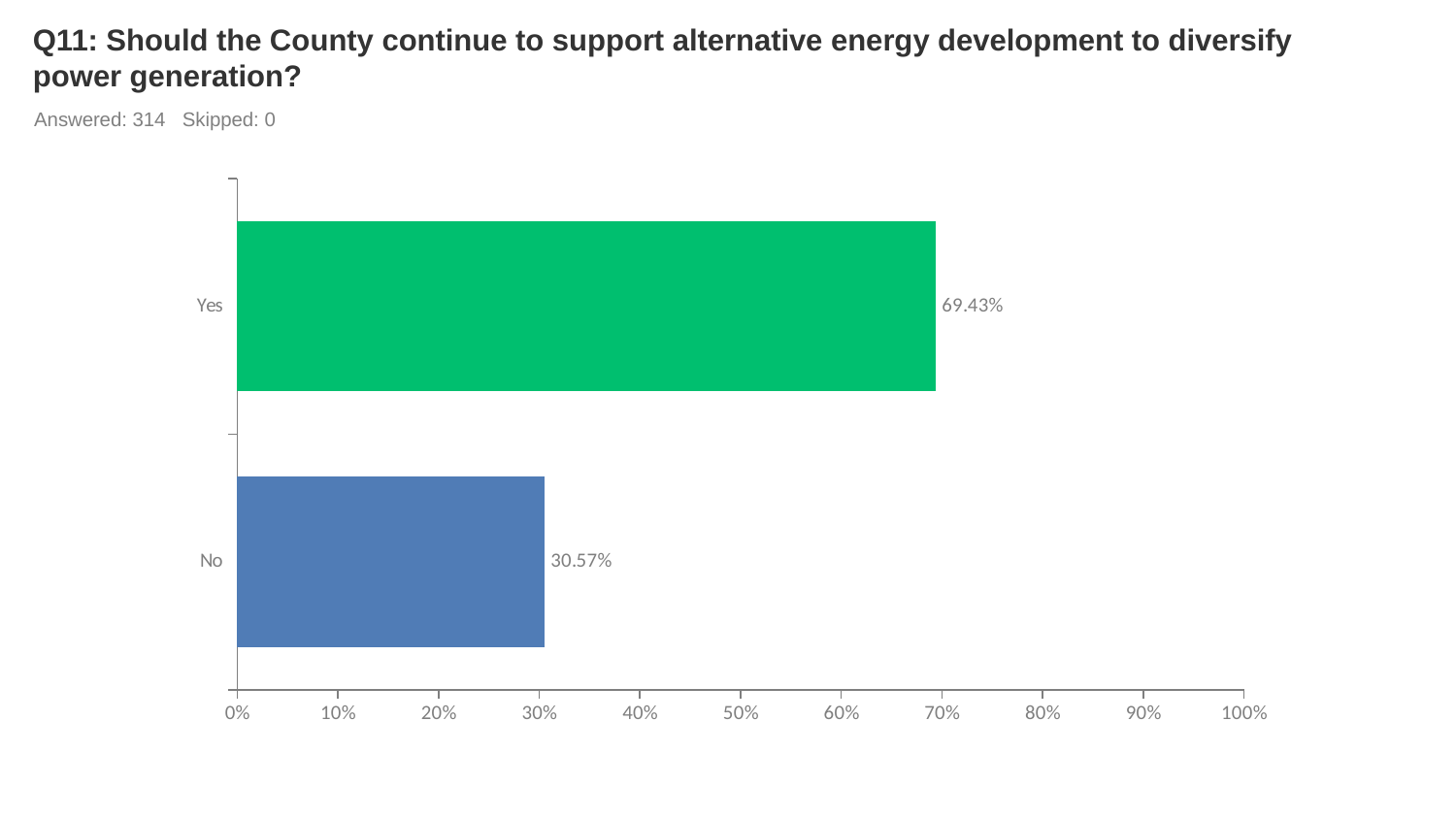
Is the value for Yes greater or less than 60%? greater What is the difference between the Yes and No percentages? 38.86% How many respondents answered this question? 314 Which is larger, the value for Yes or the value for No? Yes What percentage of respondents answered No? 30.57% Is the value for No greater or less than 40%? less What kind of chart is shown on the slide? bar chart Which response category has the lowest value? No How many response categories are shown in the chart? 2 Which response category has the highest value? Yes What percentage of respondents answered Yes? 69.43% What colour is the bar for Yes? green